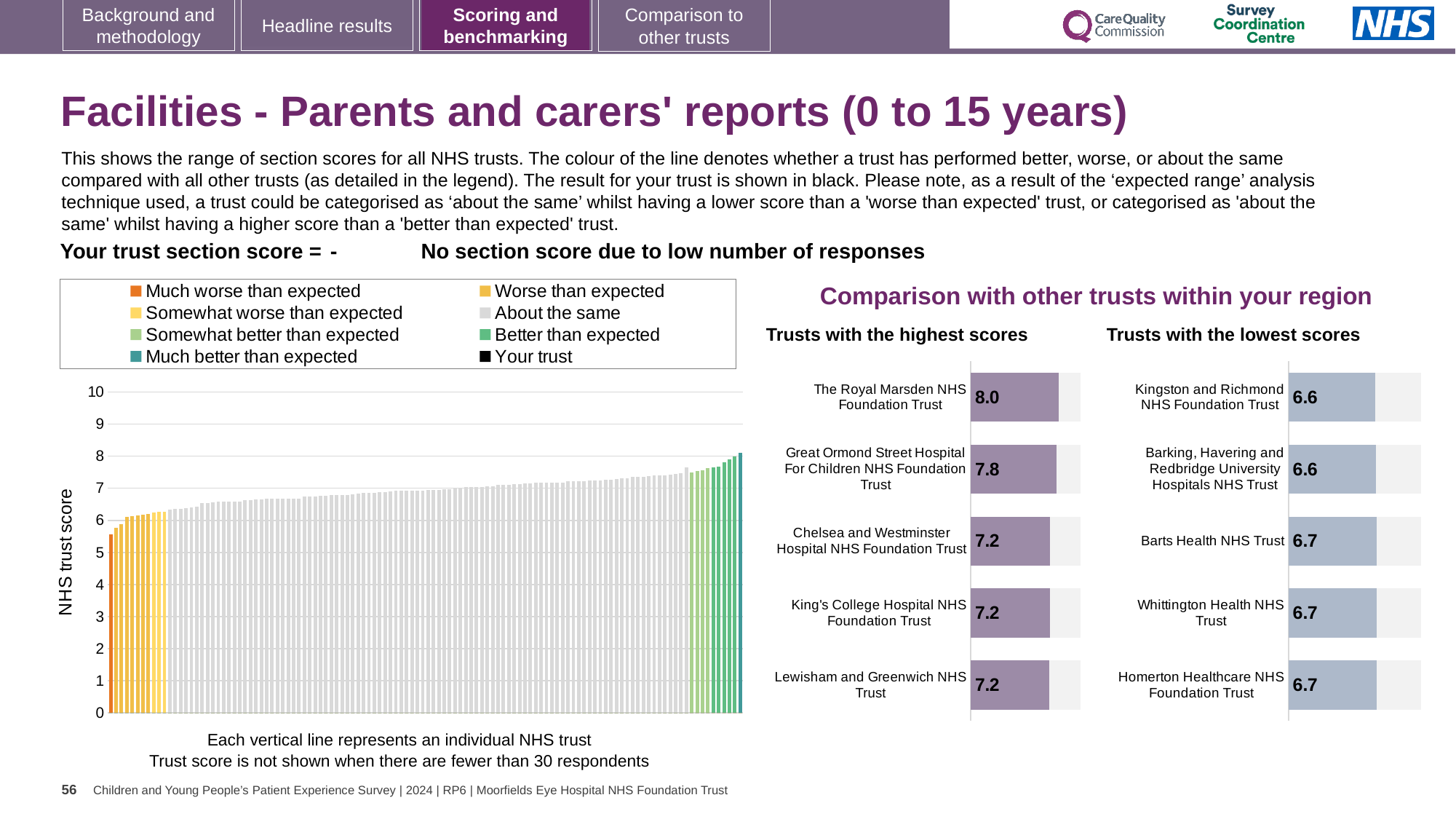
In the large chart on the left, do the NHS trust scores rise or fall from left to right? Rise In the 'Trusts with the highest scores' chart, what is the score for Great Ormond Street Hospital For Children NHS Foundation Trust? 7.8 How many entries does the legend above the large chart on the left list? 8 In the 'Trusts with the highest scores' chart, how many trusts have a score of 7.2? 3 In the 'Trusts with the highest scores' chart, what is the difference between the scores of The Royal Marsden NHS Foundation Trust and Great Ormond Street Hospital For Children NHS Foundation Trust? 0.2 In the 'Trusts with the highest scores' chart, which trust has the highest score? The Royal Marsden NHS Foundation Trust How many trusts are listed in the 'Trusts with the lowest scores' chart? 5 In the large chart on the left, is the value of the leftmost bar greater or less than 6? less In the 'Trusts with the lowest scores' chart, what is the score for Barts Health NHS Trust? 6.7 In the 'Trusts with the highest scores' chart, what is the score for The Royal Marsden NHS Foundation Trust? 8.0 What type of chart is the large chart on the left showing NHS trust scores? Bar chart In the 'Trusts with the lowest scores' chart, which is larger: the score for Kingston and Richmond NHS Foundation Trust or the score for Whittington Health NHS Trust? Whittington Health NHS Trust